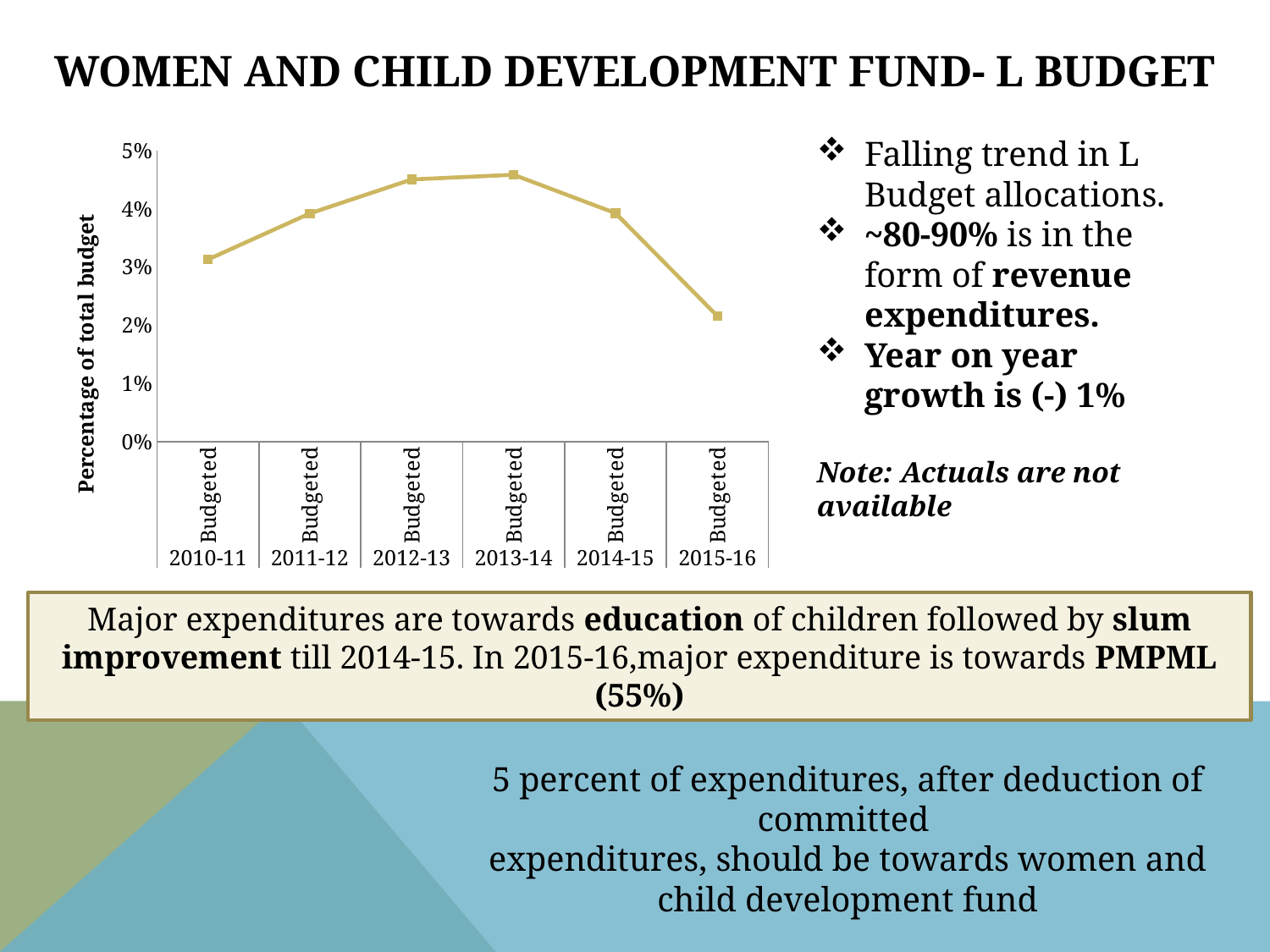
Is the budgeted value for 2015-16 greater or less than 3%? less How many data points are plotted on the line chart? 6 Which year has the lowest budgeted percentage of total budget? 2015-16 Is the budgeted value for 2012-13 greater or less than 4%? greater Which is larger, the budgeted value for 2010-11 or for 2015-16? 2010-11 How does the budgeted percentage change from 2013-14 to 2015-16? It falls What kind of chart is shown on the slide? line chart Is the budgeted value for 2014-15 greater or less than 3%? greater What is the label on the vertical axis of the chart? Percentage of total budget Which is larger, the budgeted value for 2012-13 or for 2010-11? 2012-13